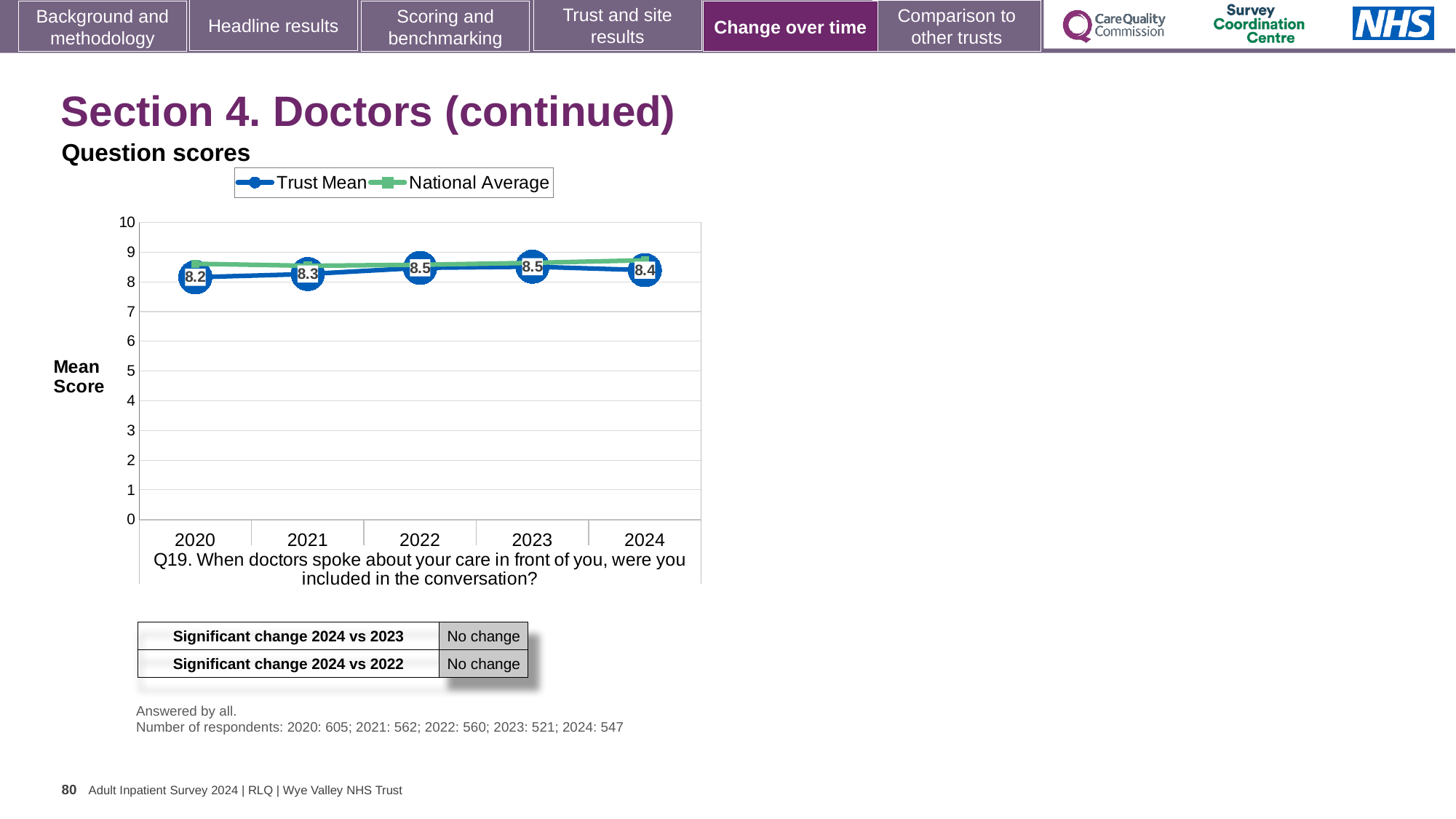
In which year is the Trust Mean score lowest? 2020 What is the label of the y axis? Mean Score Which year has the larger Trust Mean score, 2021 or 2022? 2022 What is the Trust Mean score for 2024? 8.4 What is the Trust Mean score for 2020? 8.2 What is the Trust Mean score for 2022? 8.5 What is the difference between the Trust Mean score in 2024 and in 2020? 0.2 What kind of chart is shown? Line chart Does the Trust Mean score rise or fall from 2020 to 2022? Rise How many series does the legend list? 2 How many years are plotted on the x axis? 5 Is the National Average value for 2020 greater or less than 8? greater